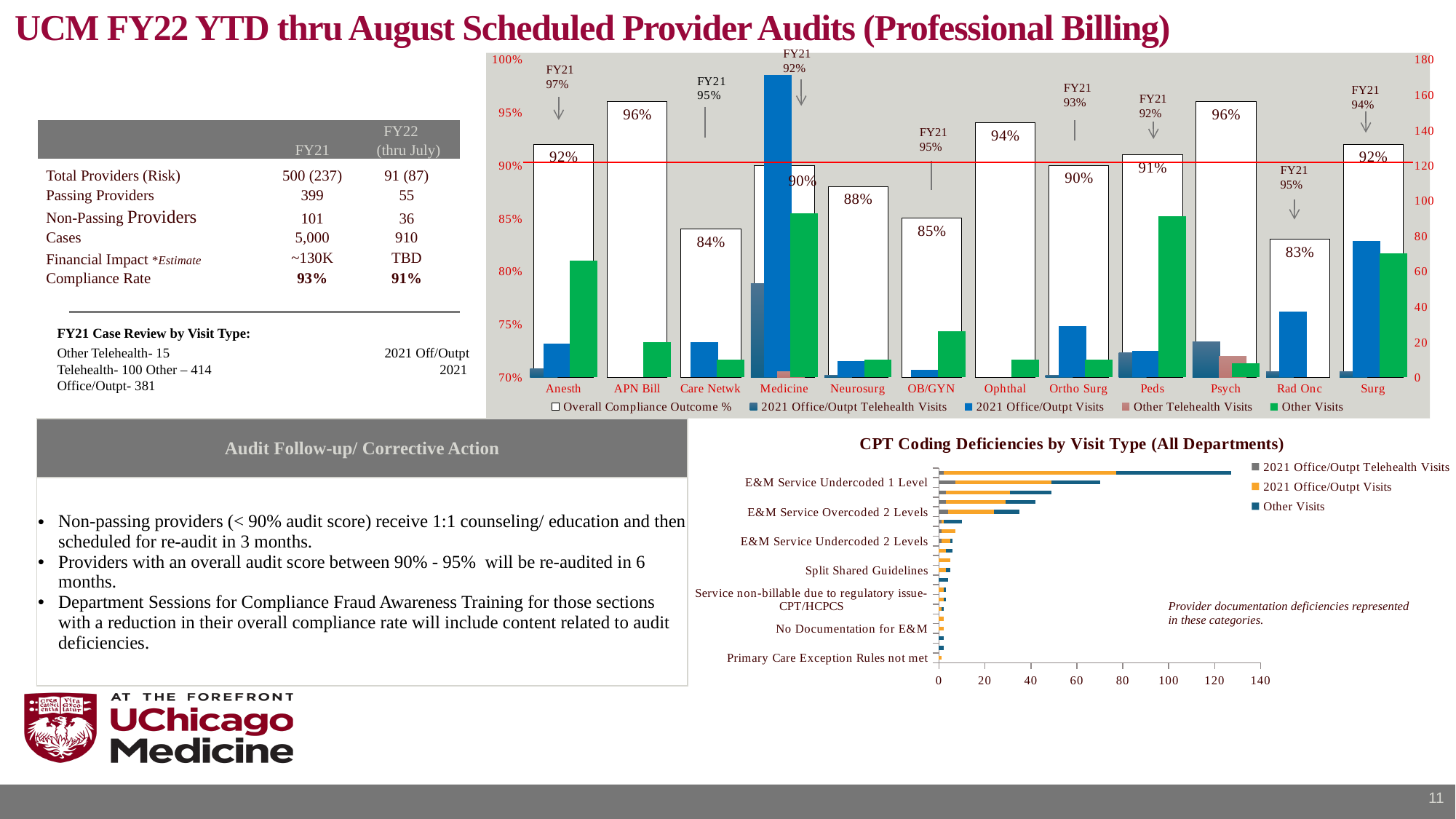
In the top-right chart, which department has the lowest Overall Compliance Outcome %? Rad Onc How many series does the legend of the bottom-right chart list? 3 In the bottom-right chart, is the longest bar greater or less than 100? greater In the top-right chart, what is the difference in Overall Compliance Outcome % between APN Bill and Care Netwk? 12 percentage points How many series does the legend of the top-right chart list? 5 In the top-right chart, what is the Overall Compliance Outcome % for Care Netwk? 84% In the top-right chart, which has a higher Overall Compliance Outcome %, Ophthal or OB/GYN? Ophthal In the top-right chart, what is the Overall Compliance Outcome % for Neurosurg? 88% How many departments are shown on the x axis of the top-right chart? 12 What is the title of the bottom-right chart? CPT Coding Deficiencies by Visit Type (All Departments) What kind of chart is the bottom-right chart? Bar chart In the top-right chart, what is the Overall Compliance Outcome % for Anesth? 92%